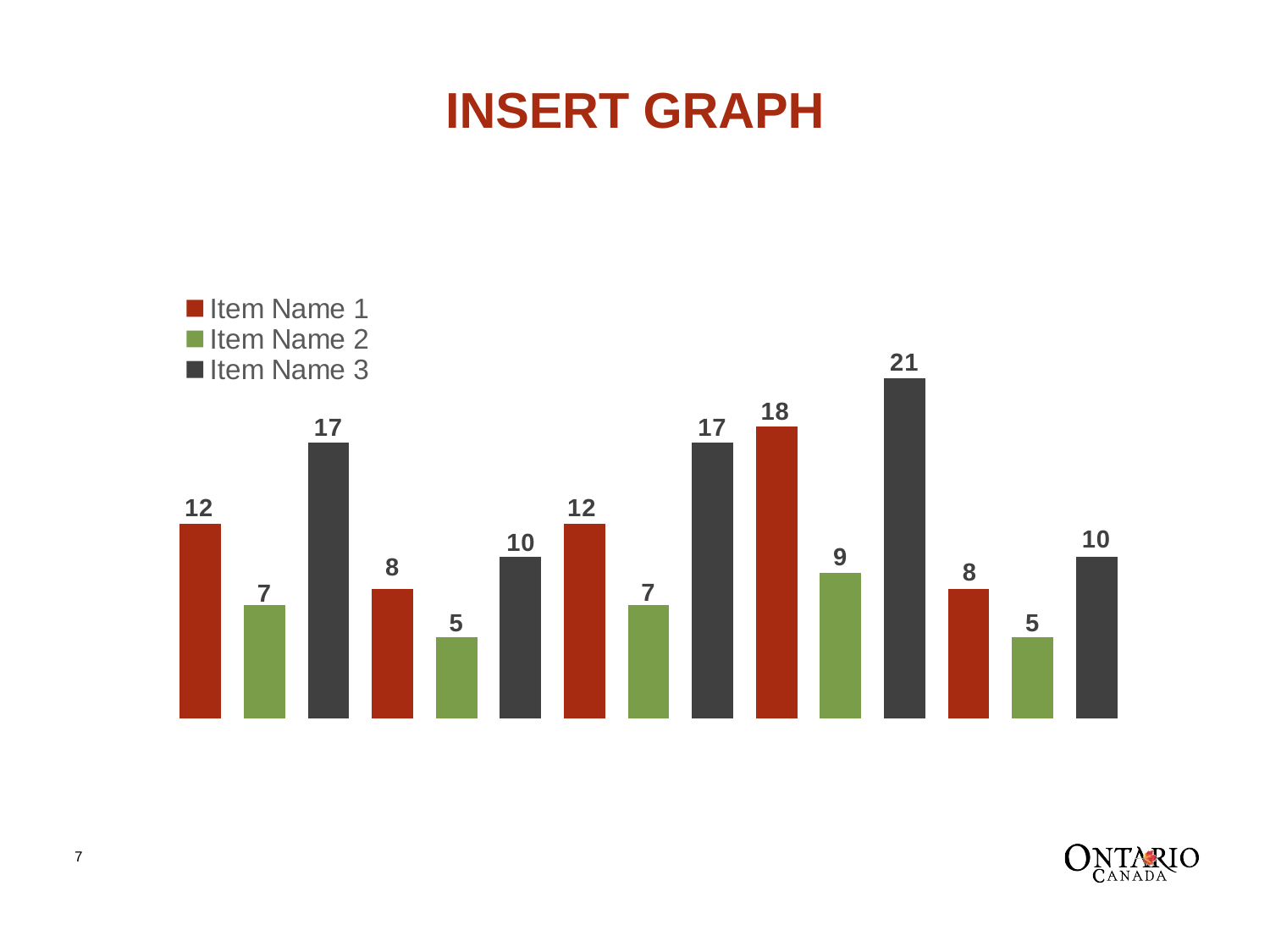
What is the title of the slide above the chart? INSERT GRAPH Which series has the highest value in the fourth group of bars from the left? Item Name 3 What is the highest value shown on any bar in the chart? 21 What is the lowest value shown on any bar in the chart? 5 How many series does the legend list? 3 What is the value of Item Name 1 in the fourth group of bars from the left? 18 What type of chart is shown on the slide? bar chart What is the value of Item Name 2 in the fourth group of bars from the left? 9 In the fourth group of bars from the left, what is the difference between the Item Name 3 value and the Item Name 1 value? 3 What is the value of Item Name 3 in the first group of bars from the left? 17 In the second group of bars from the left, which is larger: Item Name 1 or Item Name 2? Item Name 1 How many groups of bars are plotted in the chart? 5